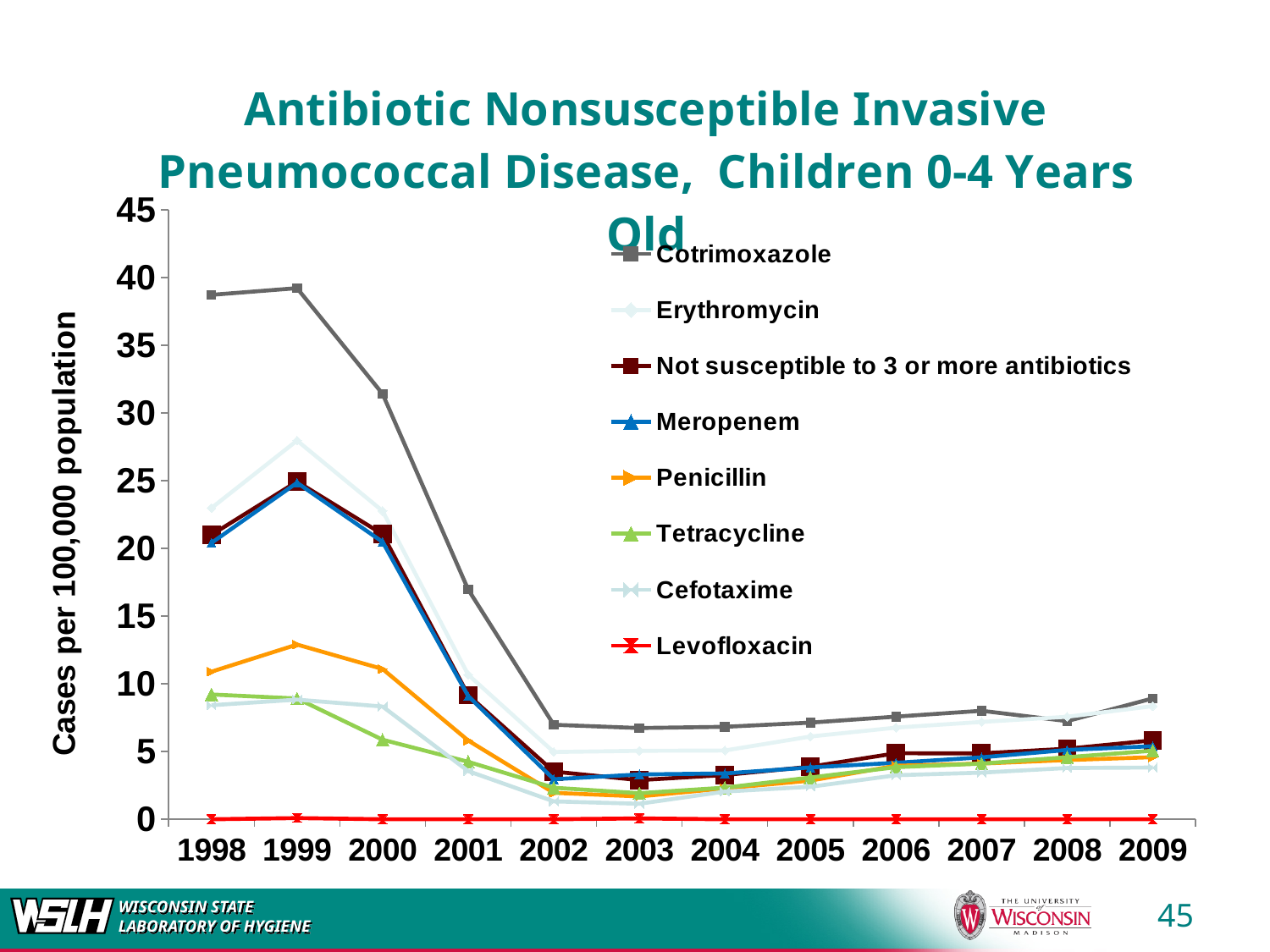
Is the value for Cotrimoxazole in 1998 greater or less than 35? greater Does the value for Cotrimoxazole rise or fall from 1999 to 2002? fall Is the value for Penicillin in 1999 greater or less than 10? greater Is the value for Cotrimoxazole in 2002 greater or less than 10? less How many series does the legend list? 8 How many years are shown along the x axis? 12 Which series has the lowest value in 2005? Levofloxacin Which series has the highest value in 1998? Cotrimoxazole Which is larger in 2000, the value for Cotrimoxazole or the value for Penicillin? Cotrimoxazole What is the title of the y axis? Cases per 100,000 population What kind of chart is shown on the slide? line chart